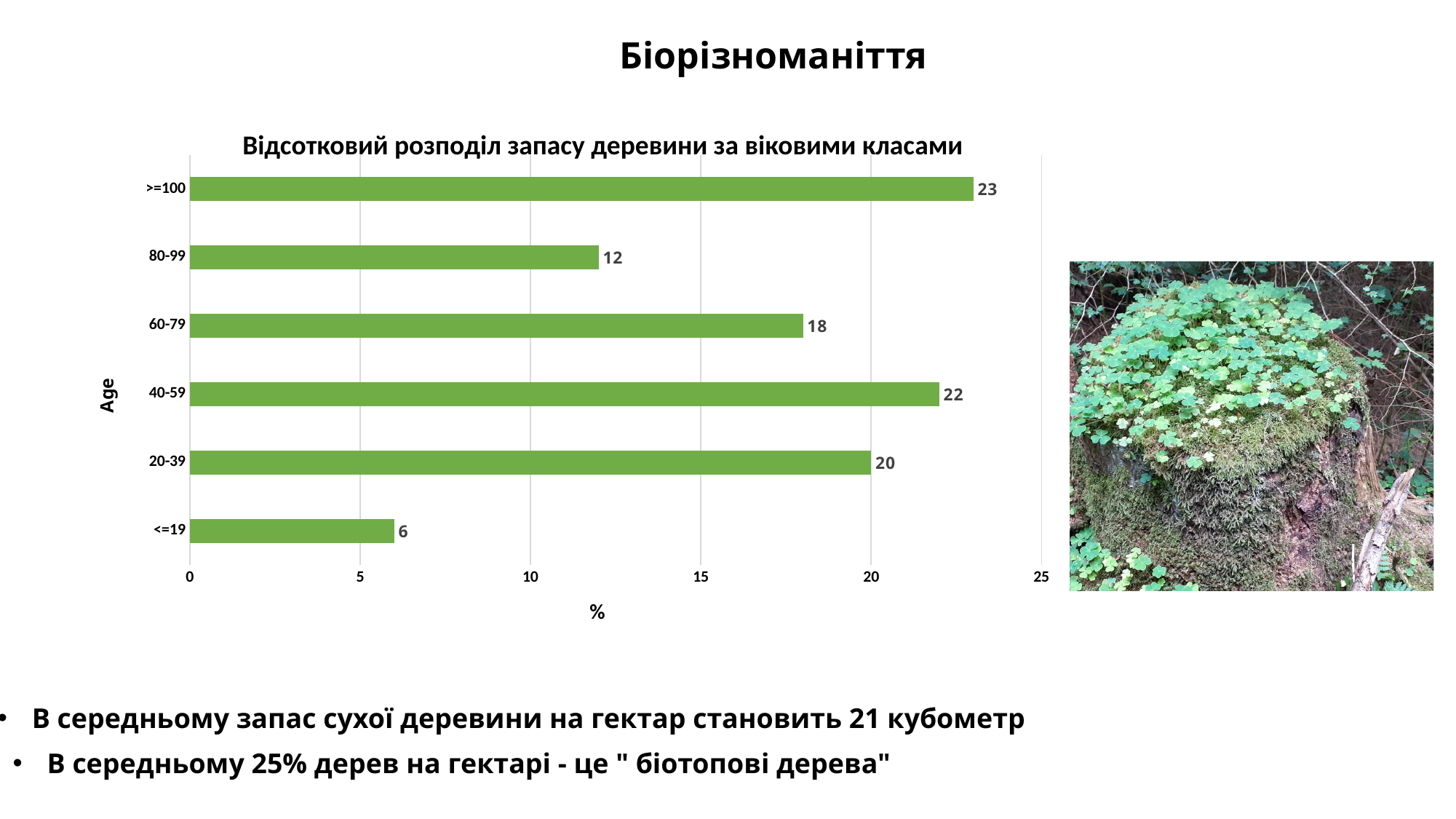
Which age class has the highest value? >=100 Is the value for 60-79 greater or less than 15? greater Which age class has the lowest value? <=19 What is the label of the horizontal axis of the chart? % What is the value for the >=100 age class? 23 What kind of chart is shown on the slide? bar chart What is the title of the chart? Відсотковий розподіл запасу деревини за віковими класами Which is larger, the value for 20-39 or the value for 80-99? 20-39 What is the difference between the values for 40-59 and 60-79? 4 How many age classes are shown in the chart? 6 What is the value for the 80-99 age class? 12 What is the value for the <=19 age class? 6